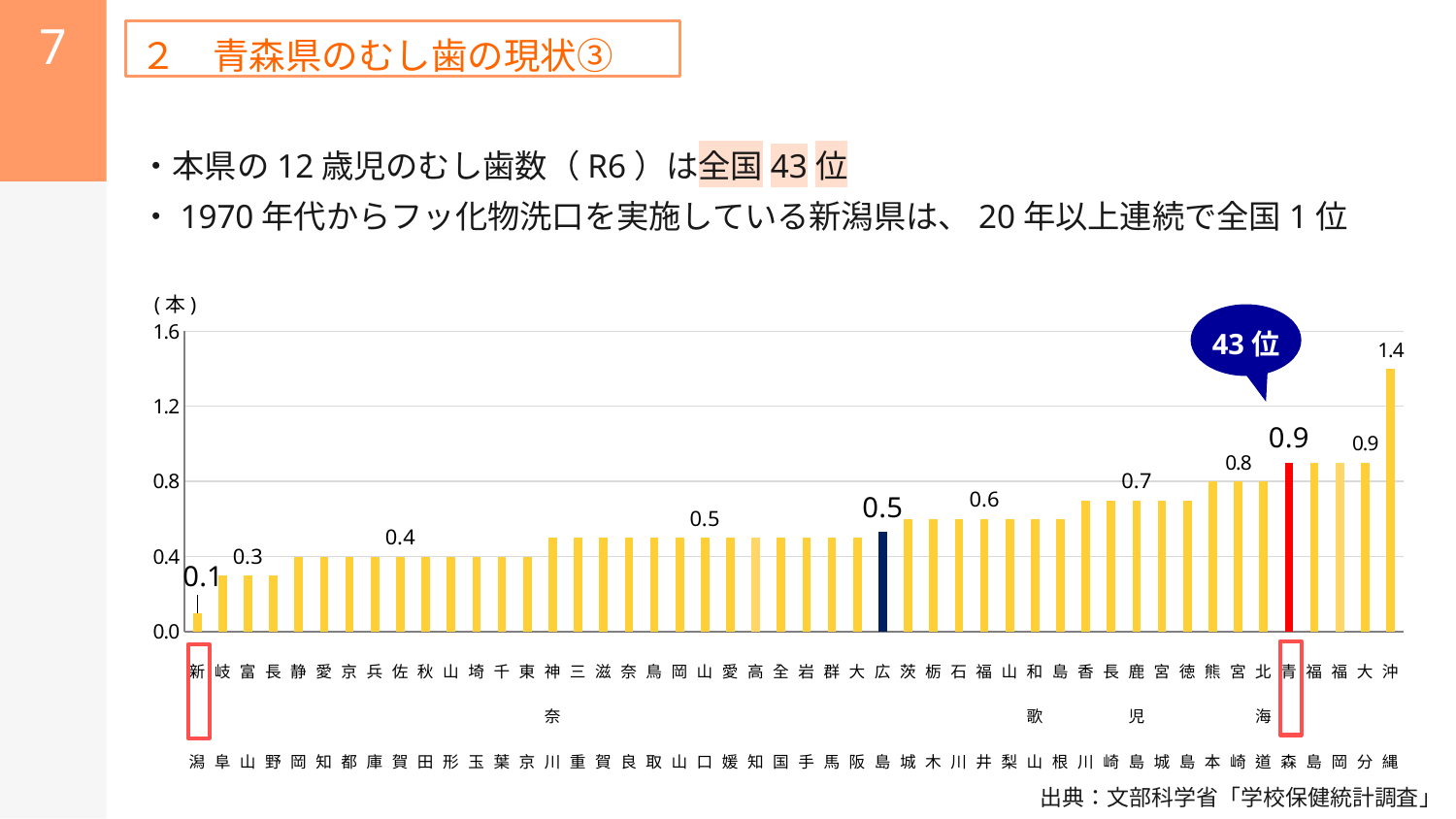
What is the value for 新潟 (Niigata)? 0.1 What is the value for 岐阜 (Gifu)? 0.3 What is the value for 広島 (Hiroshima), the dark blue bar? 0.5 What is the value for 青森 (Aomori)? 0.9 What rank is shown in the callout above the 青森 bar? 43位 Which prefecture has the highest value? 沖縄 What is the value for 沖縄 (Okinawa)? 1.4 What kind of chart is shown on the slide? bar chart Which is larger, the value for 青森 or the value for 広島? 青森 What is the difference between the values for 沖縄 and 新潟? 1.3 Which prefecture has the lowest value? 新潟 Is the value for 東京 (Tokyo) greater or less than 0.8? less